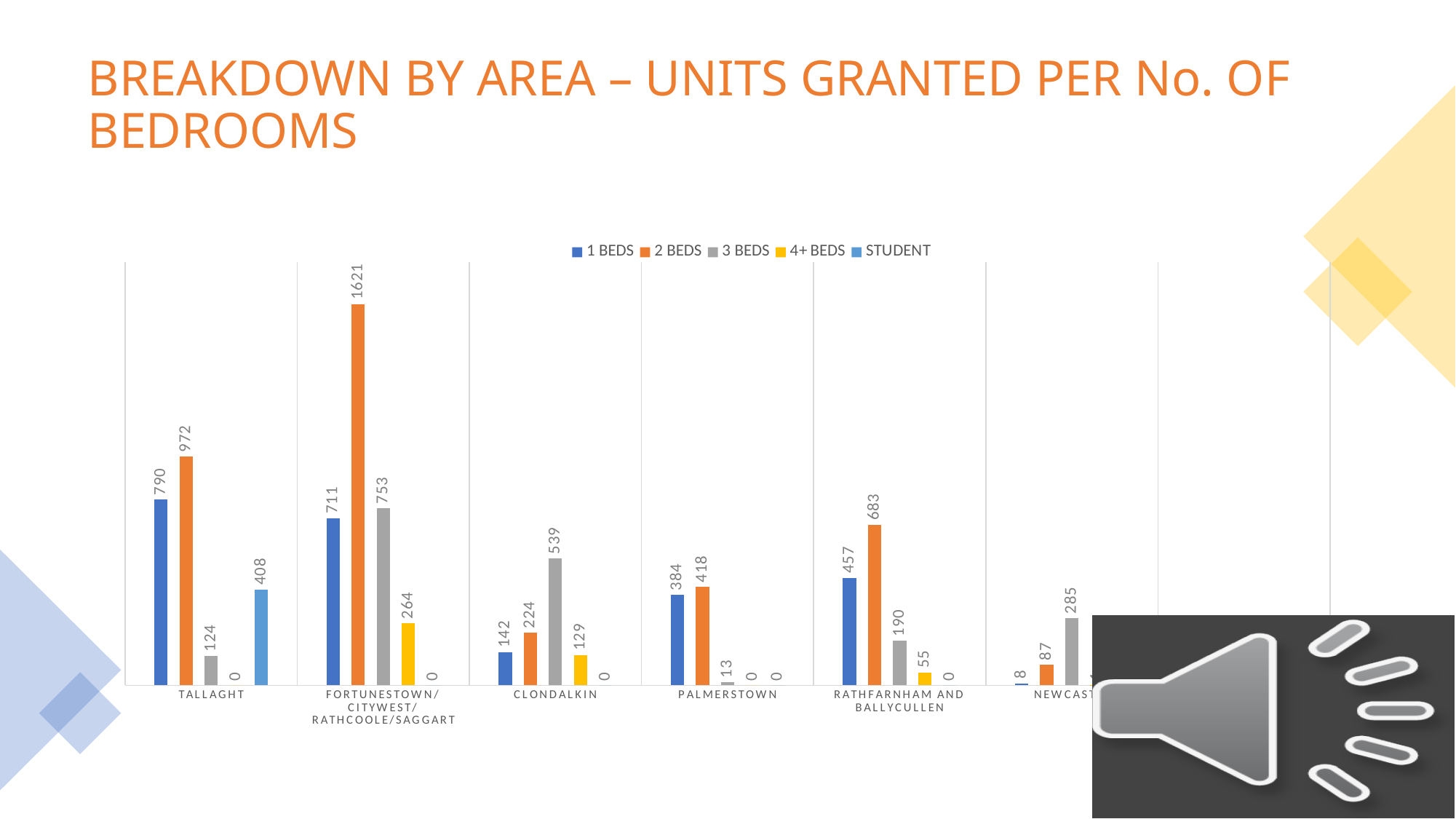
What type of chart is shown on the slide? bar chart What is the value for 2 Beds in Fortunestown/Citywest/Rathcoole/Saggart? 1621 What is the difference between the 2 Beds and 1 Beds values in Tallaght? 182 What is the value for 1 Beds in Palmerstown? 384 Which is larger in Clondalkin, the 1 Beds value or the 4+ Beds value? 1 Beds What is the value for 4+ Beds in Rathfarnham and Ballycullen? 55 How many series does the legend list? 5 What is the value for 3 Beds in Clondalkin? 539 Which series has the lowest value in Palmerstown among 1 Beds, 2 Beds and 3 Beds? 3 Beds Which series is shown in yellow in the legend? 4+ Beds What is the value for Student in Tallaght? 408 Which area has the highest value for 2 Beds? Fortunestown/Citywest/Rathcoole/Saggart